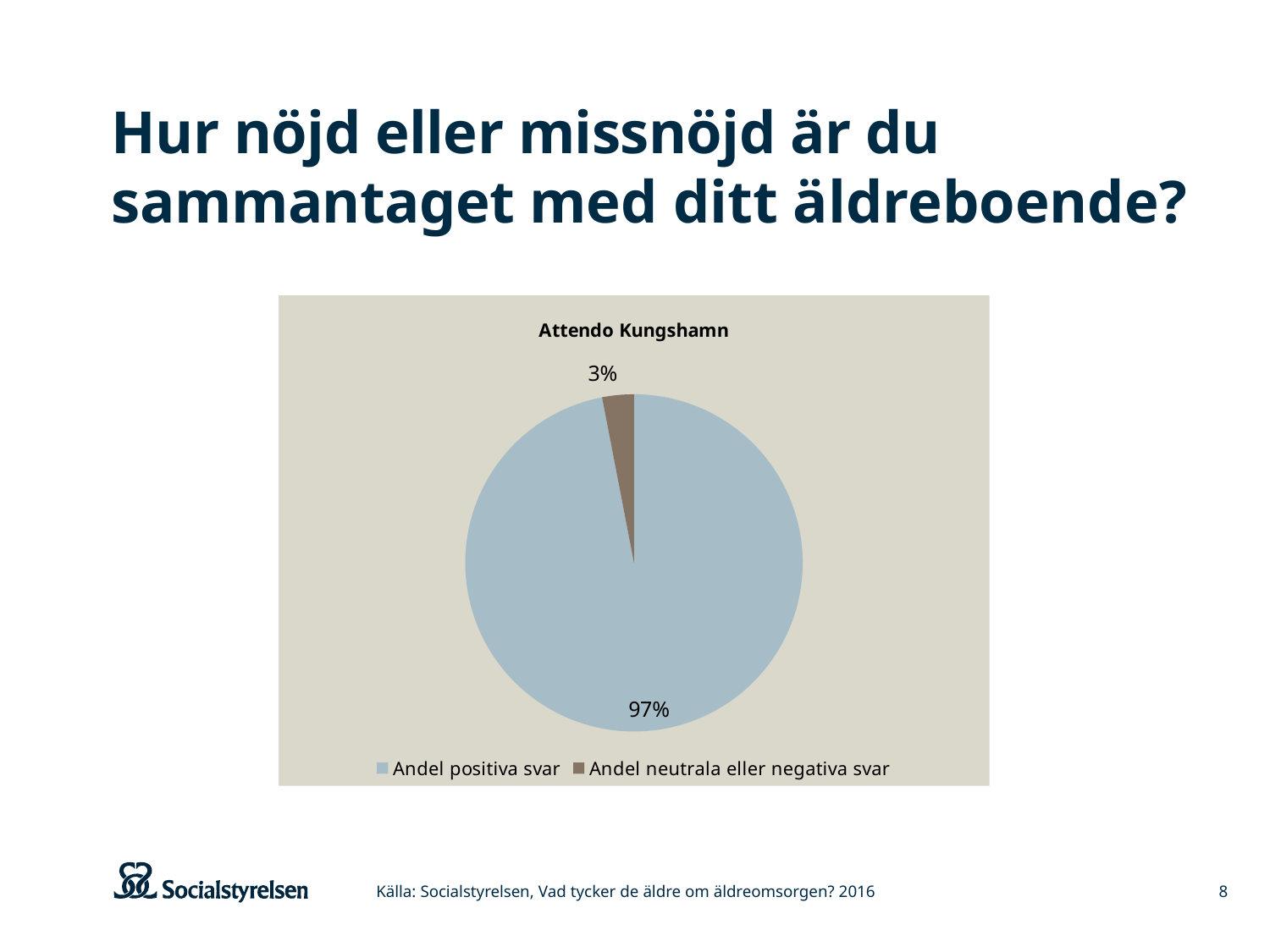
What share of the pie is 'Andel positiva svar'? 97% What is the chart's title? Attendo Kungshamn What colour is the 'Andel positiva svar' slice? light blue Which is larger: 'Andel positiva svar' or 'Andel neutrala eller negativa svar'? Andel positiva svar How many slices does the pie chart have? 2 What is the difference between the 'Andel positiva svar' share and the 'Andel neutrala eller negativa svar' share? 94% What share of the pie is 'Andel neutrala eller negativa svar'? 3% Which slice is the largest? Andel positiva svar Which slice is the smallest? Andel neutrala eller negativa svar How many entries does the legend list? 2 Is the share for 'Andel positiva svar' greater or less than 90%? greater What kind of chart is shown on the slide? pie chart